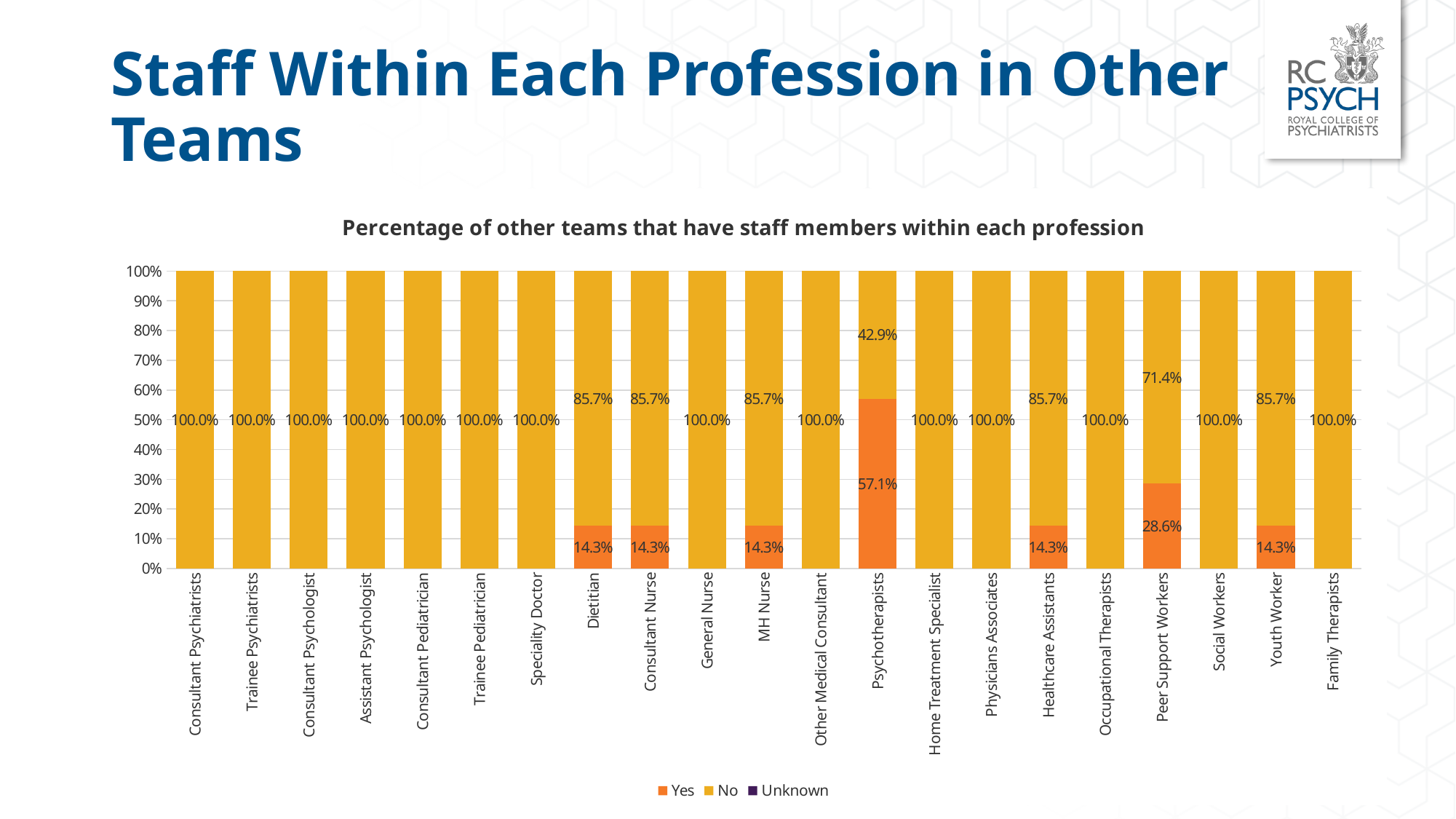
What is the 'No' value for Peer Support Workers? 71.4% How many professions are shown on the x axis? 21 What is the 'Yes' value for Psychotherapists? 57.1% What is the 'No' value for Consultant Psychiatrists? 100.0% How many series does the legend list? 3 What is the title of the chart? Percentage of other teams that have staff members within each profession Which is larger, the 'Yes' value for Peer Support Workers or the 'Yes' value for Youth Worker? Peer Support Workers Which profession has the lowest 'No' value? Psychotherapists Which profession has the highest 'Yes' value? Psychotherapists What kind of chart is shown on the slide? Stacked bar chart What is the difference between the 'Yes' values for Psychotherapists and Peer Support Workers? 28.5% What is the 'Yes' value for Dietitian? 14.3%